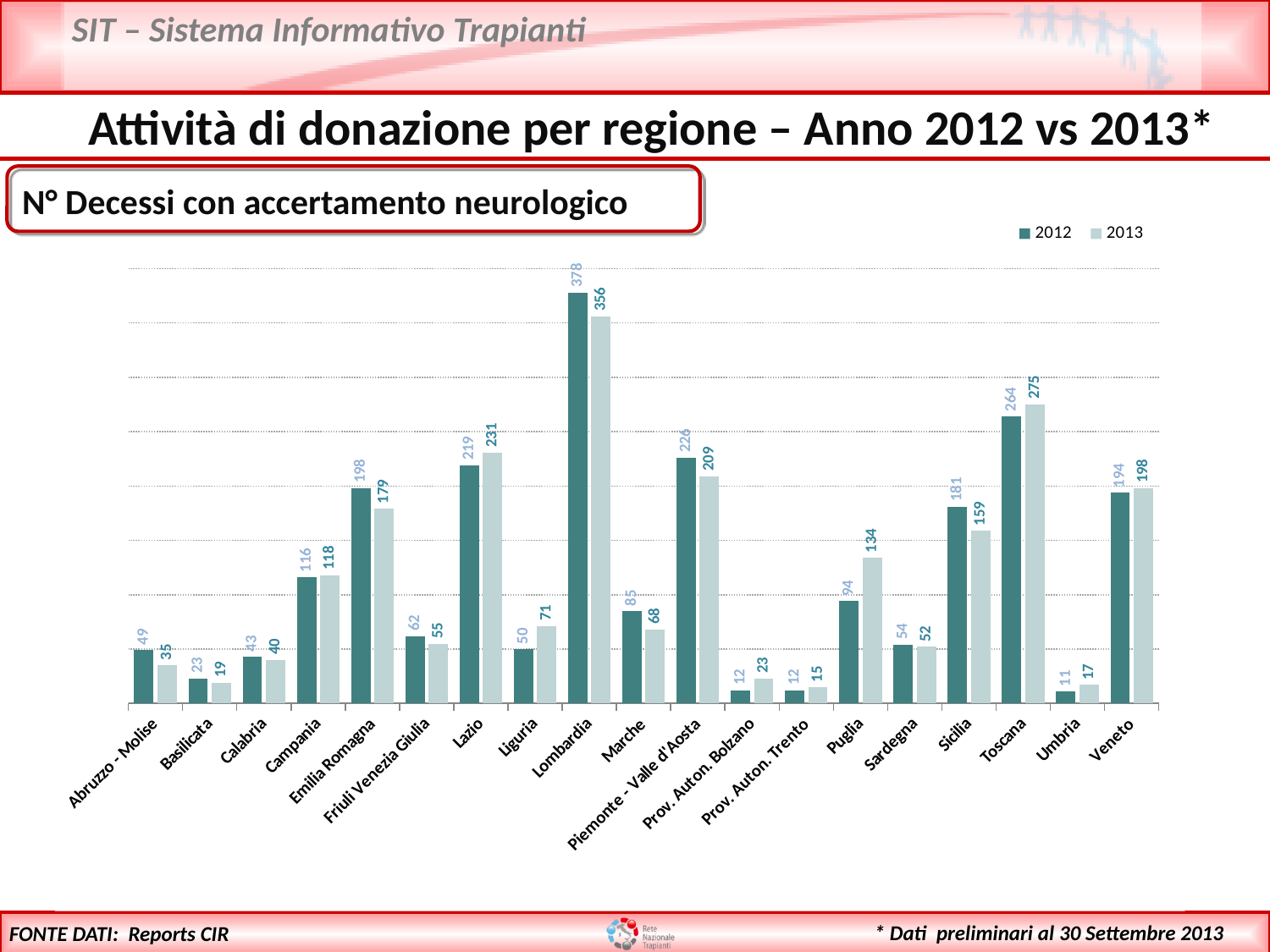
What is the value for Lombardia in 2012? 378 What is the difference between the 2012 and 2013 values for Toscana? 11 Which is larger, the 2012 value for Lazio or the 2012 value for Piemonte - Valle d'Aosta? Piemonte - Valle d'Aosta What is the difference between the 2012 and 2013 values for Sicilia? 22 Which is larger for Liguria, the 2012 value or the 2013 value? 2013 How many regions are shown on the x axis? 19 Which region has the lowest value in 2012? Umbria What is the value for Puglia in 2013? 134 Which region has the highest value in 2013? Lombardia How many series does the legend list? 2 What kind of chart is shown on the slide? Bar chart What is the value for Emilia Romagna in 2013? 179